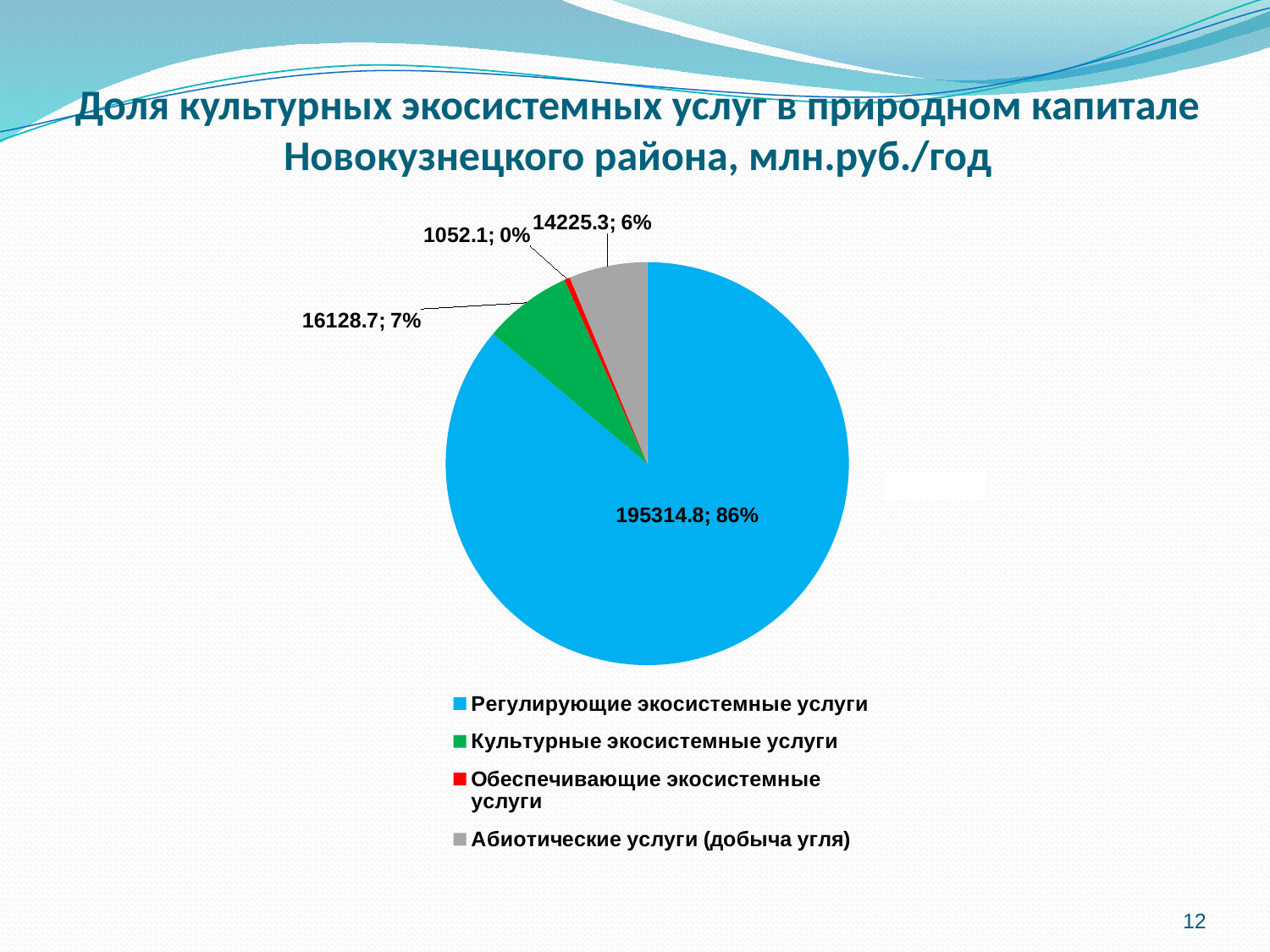
What is the difference between the values for Культурные экосистемные услуги and Абиотические услуги (добыча угля)? 1903.4 What is the value for Культурные экосистемные услуги? 16128.7 What share of the pie does Регулирующие экосистемные услуги take? 86% What is the value for Обеспечивающие экосистемные услуги? 1052.1 What is the value for Регулирующие экосистемные услуги? 195314.8 What share of the pie does Культурные экосистемные услуги take? 7% Which category has the smallest slice? Обеспечивающие экосистемные услуги Which colour represents Абиотические услуги (добыча угля) in the legend? Grey What type of chart is shown on the slide? Pie chart What is the value for Абиотические услуги (добыча угля)? 14225.3 Which category has the largest slice? Регулирующие экосистемные услуги How many categories does the pie chart have? 4